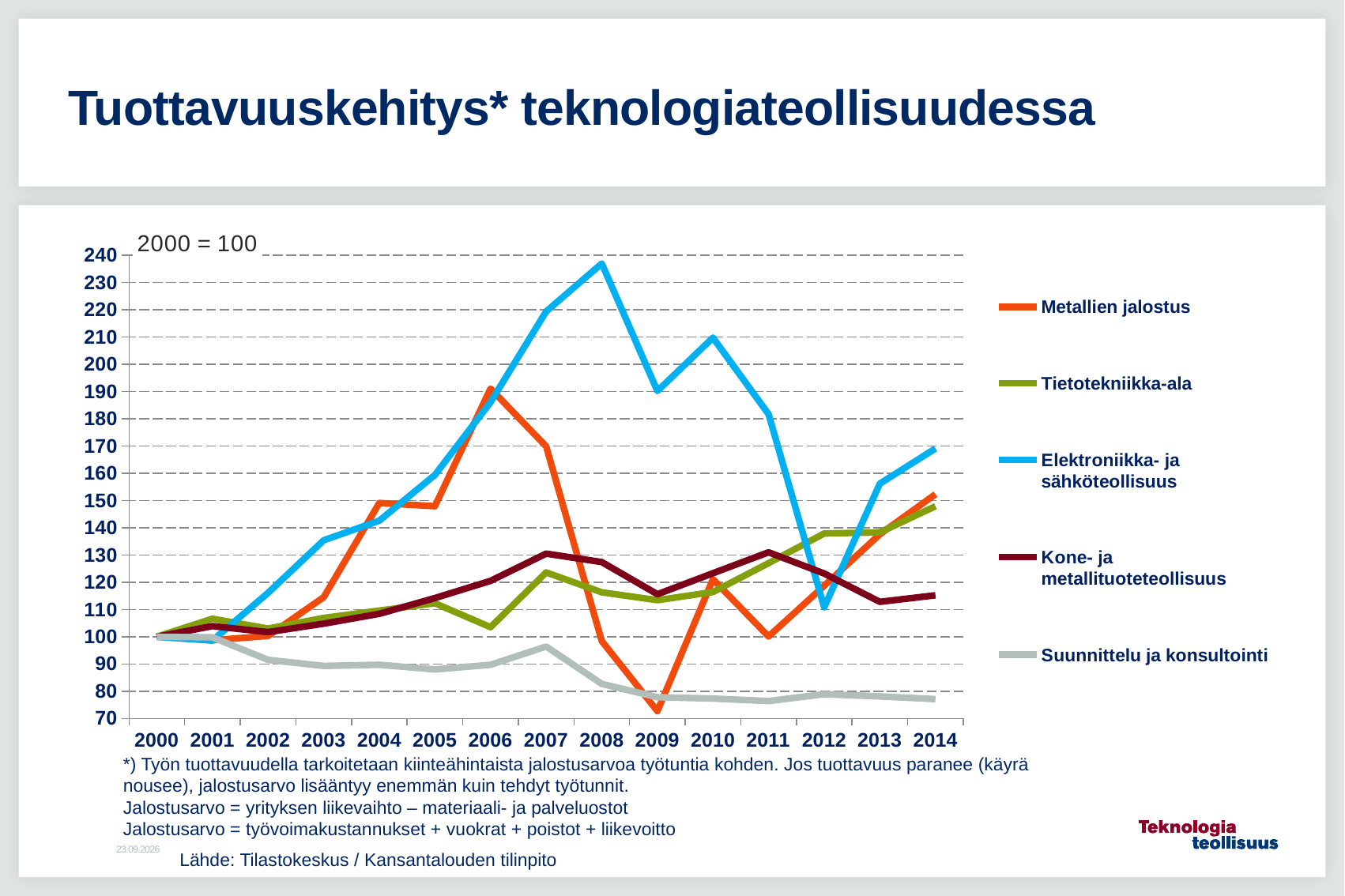
In which year does the Elektroniikka- ja sähköteollisuus line reach its peak? 2008 How many series does the legend list? 5 In 2012, which is larger: Tietotekniikka-ala or Elektroniikka- ja sähköteollisuus? Tietotekniikka-ala What base year note is printed at the top of the chart? 2000 = 100 Which series has the lowest value in 2014? Suunnittelu ja konsultointi Is the value for Kone- ja metallituoteteollisuus in 2007 greater or less than 120? greater Does the Suunnittelu ja konsultointi line rise or fall from 2000 to 2014? fall Which series reaches the highest value on the chart? Elektroniikka- ja sähköteollisuus Is the value for Elektroniikka- ja sähköteollisuus in 2008 greater or less than 230? greater How many years are shown on the x axis? 15 Is the value for Metallien jalostus in 2009 greater or less than 80? less What kind of chart is shown on the slide? line chart